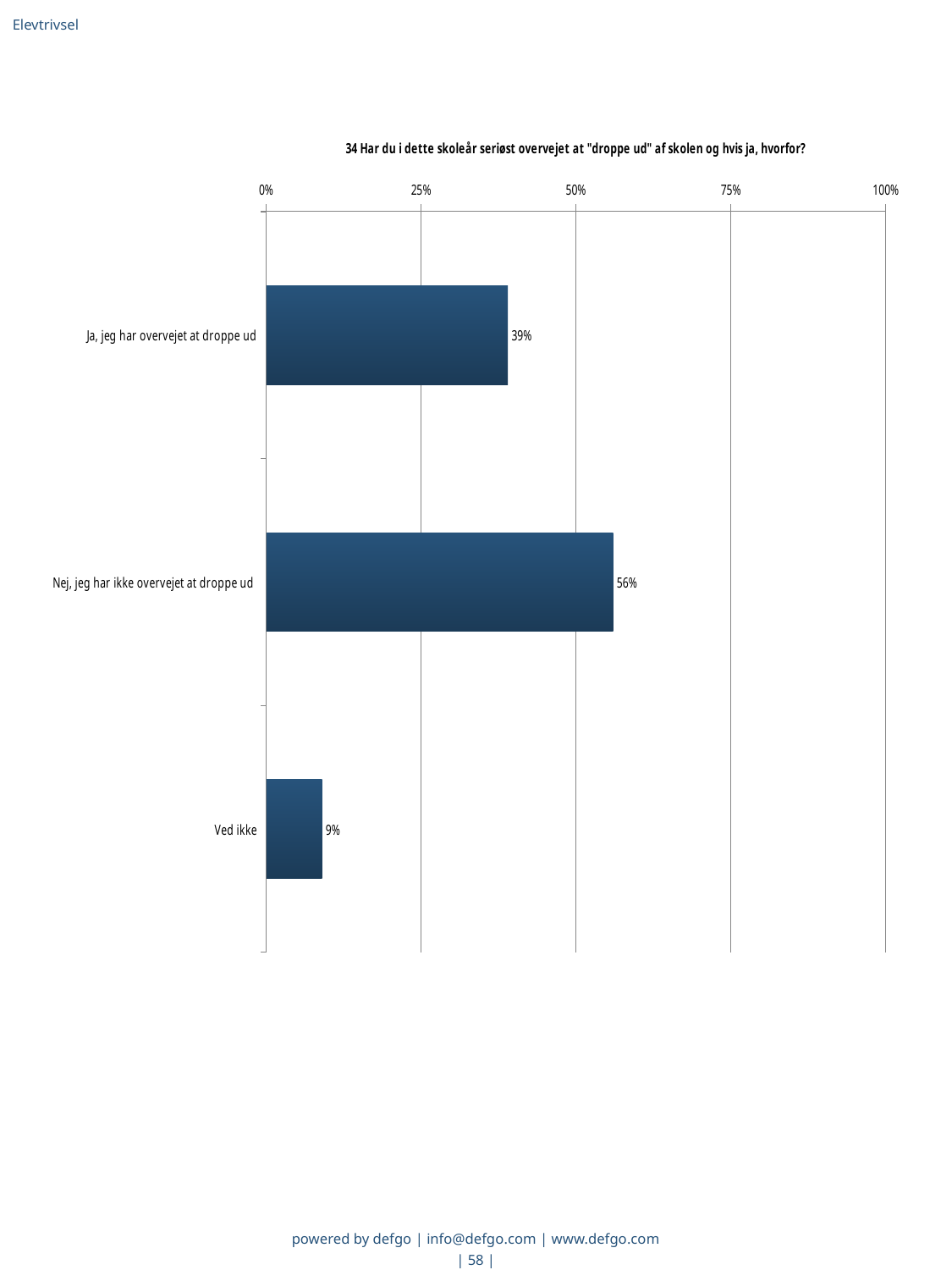
What kind of chart is shown on the slide? Bar chart What is the value for "Ved ikke"? 9% Which category has the lowest value? Ved ikke What is the difference between the values for "Nej, jeg har ikke overvejet at droppe ud" and "Ja, jeg har overvejet at droppe ud"? 17% What is the value for "Ja, jeg har overvejet at droppe ud"? 39% What is the difference between the values for "Ja, jeg har overvejet at droppe ud" and "Ved ikke"? 30% Is the value for "Nej, jeg har ikke overvejet at droppe ud" greater or less than 50%? greater Which is larger, the value for "Ja, jeg har overvejet at droppe ud" or the value for "Ved ikke"? Ja, jeg har overvejet at droppe ud What is the value for "Nej, jeg har ikke overvejet at droppe ud"? 56% Which category has the highest value? Nej, jeg har ikke overvejet at droppe ud How many categories are shown in the chart? 3 What is the title of the chart? 34 Har du i dette skoleår seriøst overvejet at "droppe ud" af skolen og hvis ja, hvorfor?